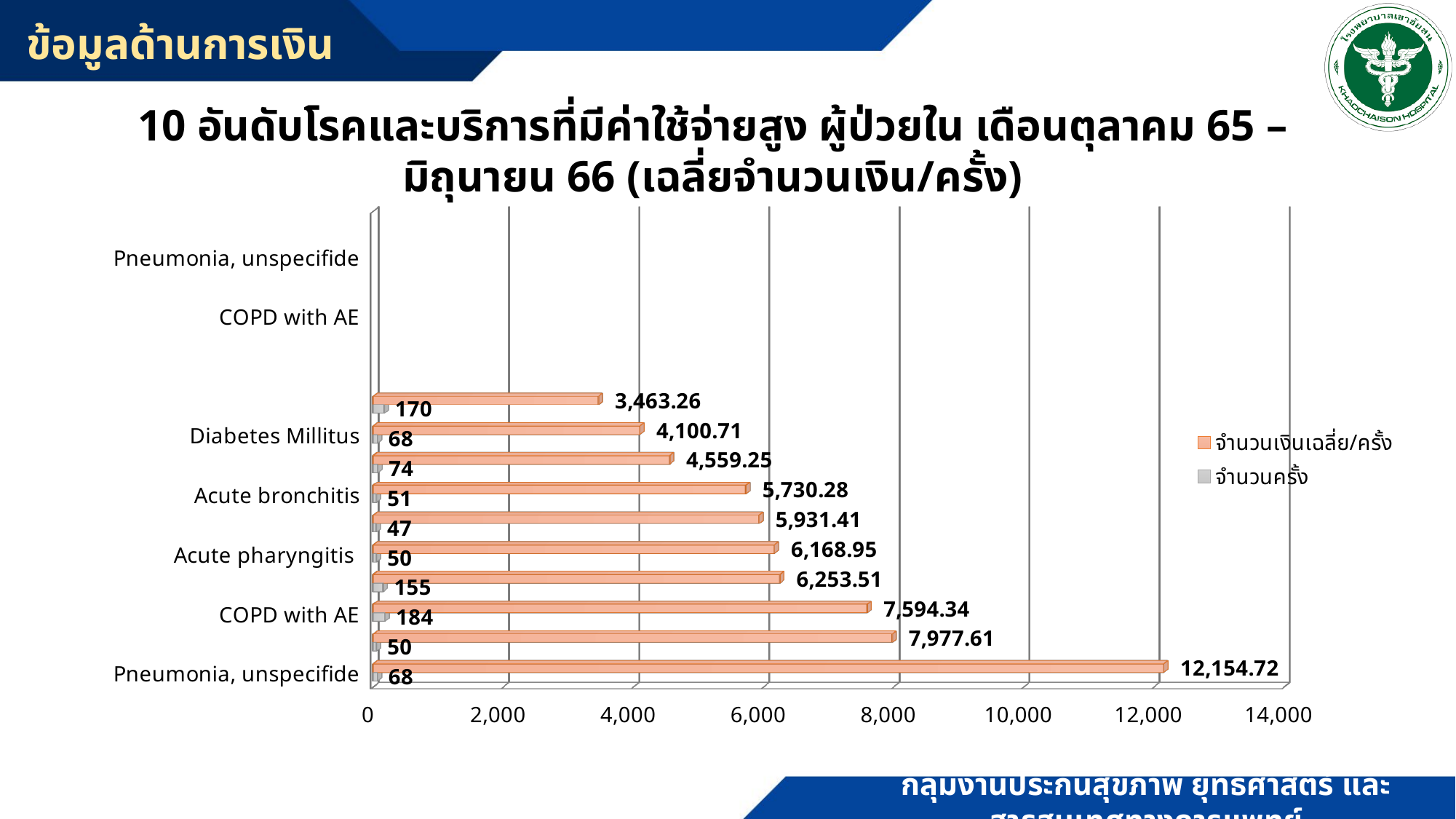
What is the จำนวนเงินเฉลี่ย/ครั้ง value for the bottom Pneumonia, unspecifide bar? 12,154.72 Which has the larger จำนวนเงินเฉลี่ย/ครั้ง value, Acute pharyngitis or Acute bronchitis? Acute pharyngitis How many series does the legend list? 2 What is the จำนวนครั้ง value for the COPD with AE bar labelled 7,594.34? 184 What are the two series named in the legend? จำนวนเงินเฉลี่ย/ครั้ง and จำนวนครั้ง What is the highest จำนวนเงินเฉลี่ย/ครั้ง value shown in the chart? 12,154.72 What is the จำนวนเงินเฉลี่ย/ครั้ง value for Acute bronchitis? 5,730.28 What kind of chart is shown on the slide? bar chart How many orange (จำนวนเงินเฉลี่ย/ครั้ง) bars are plotted in the chart? 10 What is the difference between the two largest จำนวนเงินเฉลี่ย/ครั้ง values, 12,154.72 and 7,977.61? 4,177.11 Which category has the highest จำนวนครั้ง value, and what is it? COPD with AE, 184 What is the lowest จำนวนเงินเฉลี่ย/ครั้ง value shown in the chart? 3,463.26